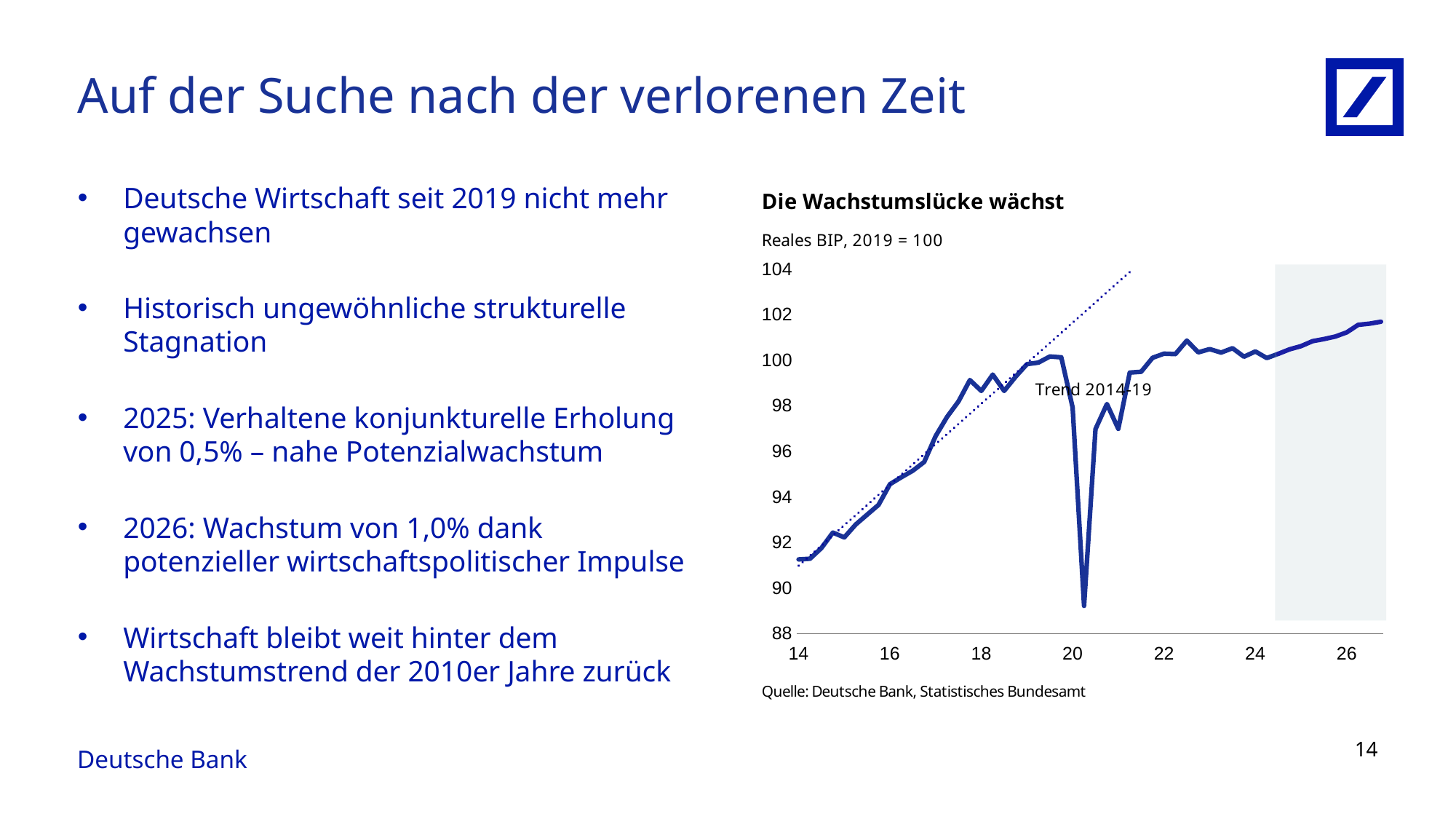
What is the highest value shown on the y axis of the chart? 104 What does the subtitle of the chart say the plotted series is? Reales BIP, 2019 = 100 Is the value of the real GDP line at the start of the series in 2014 greater or less than 92? less Does the real GDP line rise or fall between 2014 and 2019? rise What is the label of the dotted line in the chart? Trend 2014-19 What kind of chart is shown on the slide? line chart Is the lowest point of the real GDP line, around 2020, greater or less than 90? less Around which year does the real GDP line reach its lowest point? 2020 Is the value of the real GDP line at the end of the series, around 2026, greater or less than 100? greater Which is higher at the right end of the chart: the dotted trend line (extended) or the real GDP line? the dotted trend line